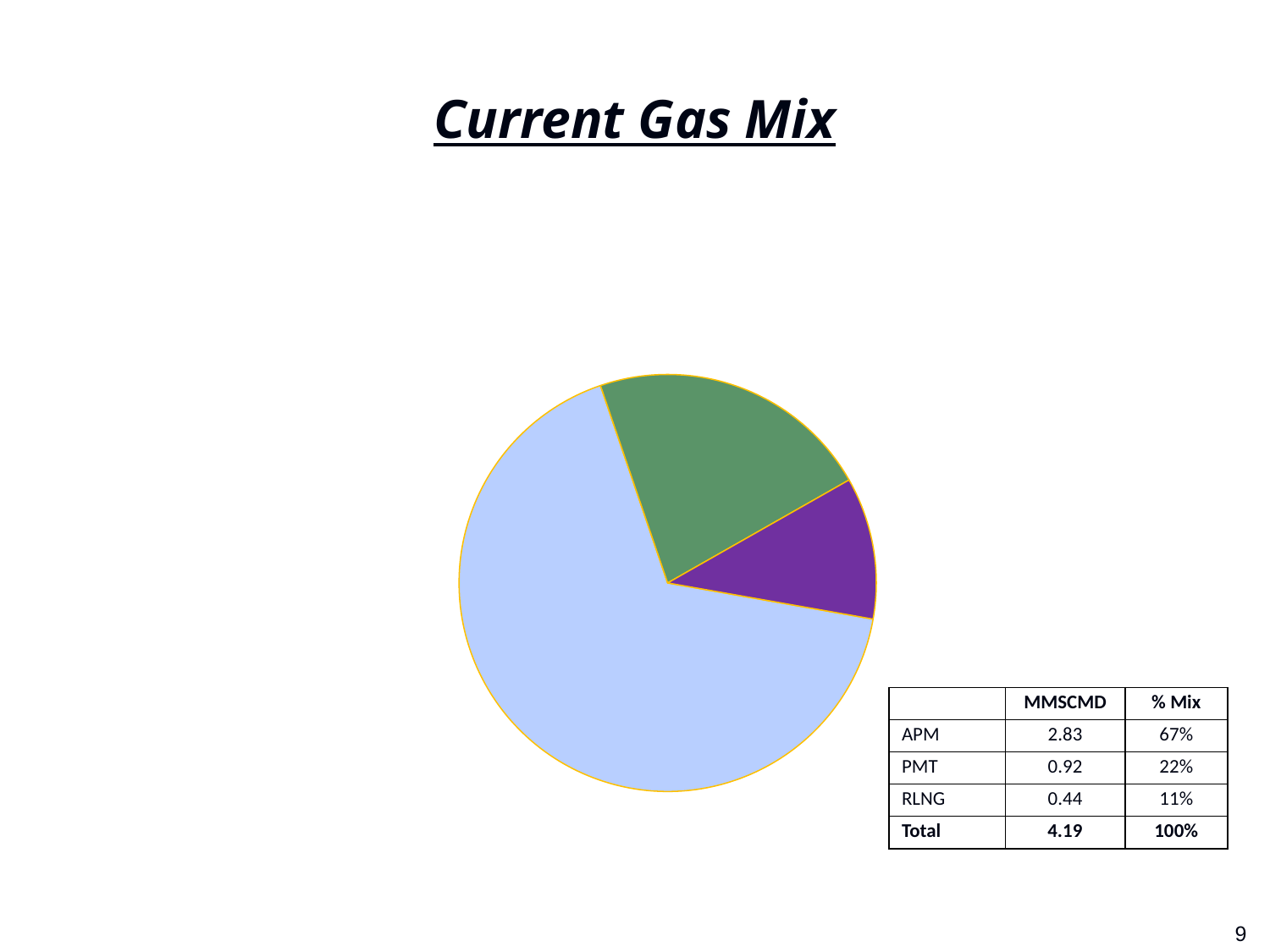
Which category has the largest slice of the pie chart? APM Which category has the smallest slice of the pie chart? RLNG What share of the gas mix does RLNG represent? 11% What kind of chart is shown on the slide? pie chart According to the table beside the pie chart, what is the MMSCMD value for RLNG? 0.44 What share of the gas mix does APM represent? 67% What is the total MMSCMD across all three categories in the gas mix? 4.19 What is the title of the slide containing the pie chart? Current Gas Mix According to the table beside the pie chart, what is the MMSCMD value for APM? 2.83 What is the difference in MMSCMD between APM and PMT? 1.91 How many slices does the pie chart have? 3 According to the table beside the pie chart, what is the MMSCMD value for PMT? 0.92